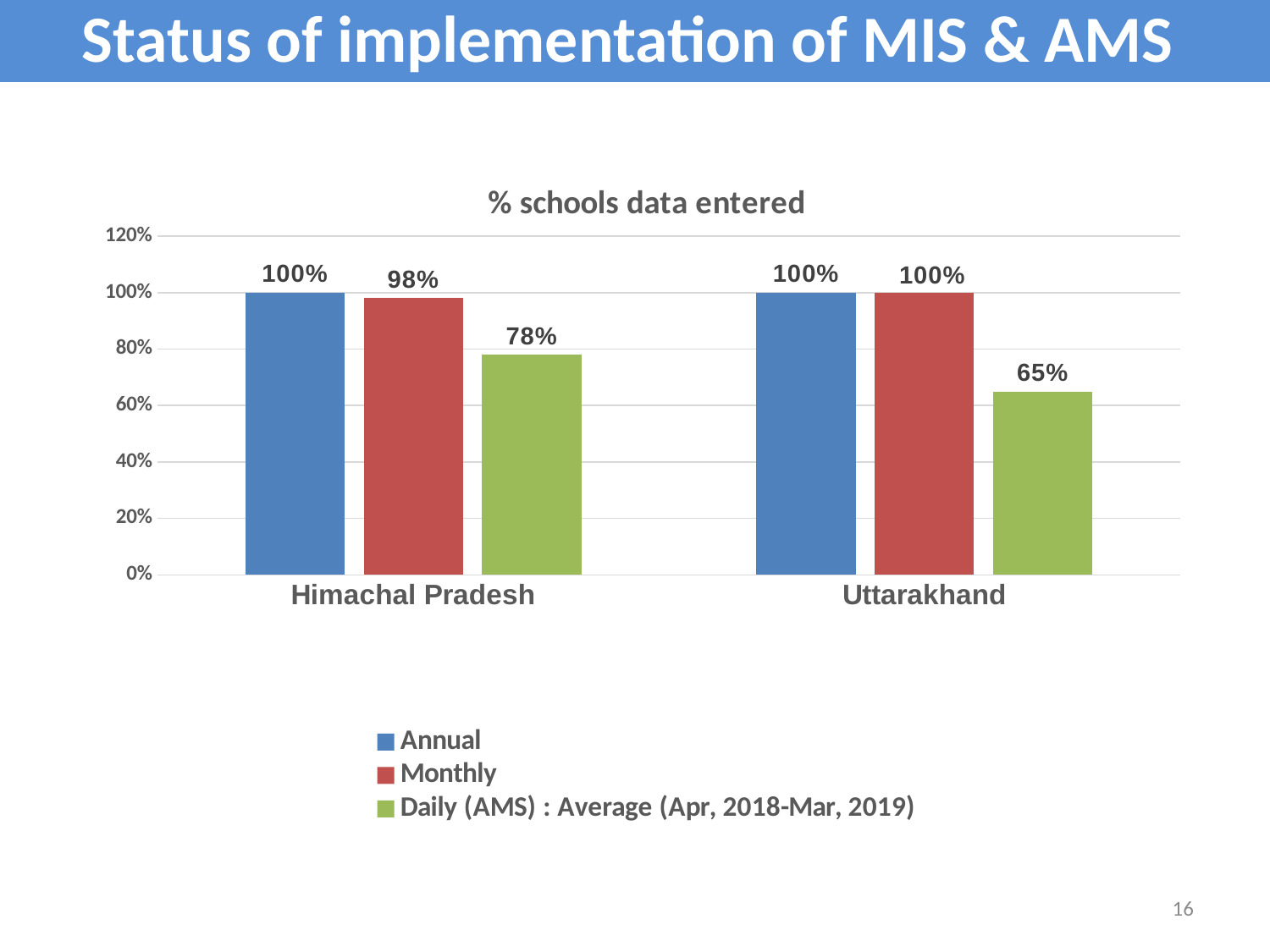
What is the difference between the Daily (AMS) values for Himachal Pradesh and Uttarakhand? 13% What is the title of the chart? % schools data entered What kind of chart is shown? bar chart How many series does the legend list? 3 What is the Daily (AMS) value for Himachal Pradesh? 78% Which state has the higher Daily (AMS) value, Himachal Pradesh or Uttarakhand? Himachal Pradesh What is the Monthly value for Himachal Pradesh? 98% What is the Daily (AMS) value for Uttarakhand? 65% What is the Annual value for Himachal Pradesh? 100% Is the Daily (AMS) value for Uttarakhand greater or less than 80%? less Which series has the lowest value for Uttarakhand? Daily (AMS) : Average (Apr, 2018-Mar, 2019) How many states are shown on the x axis? 2